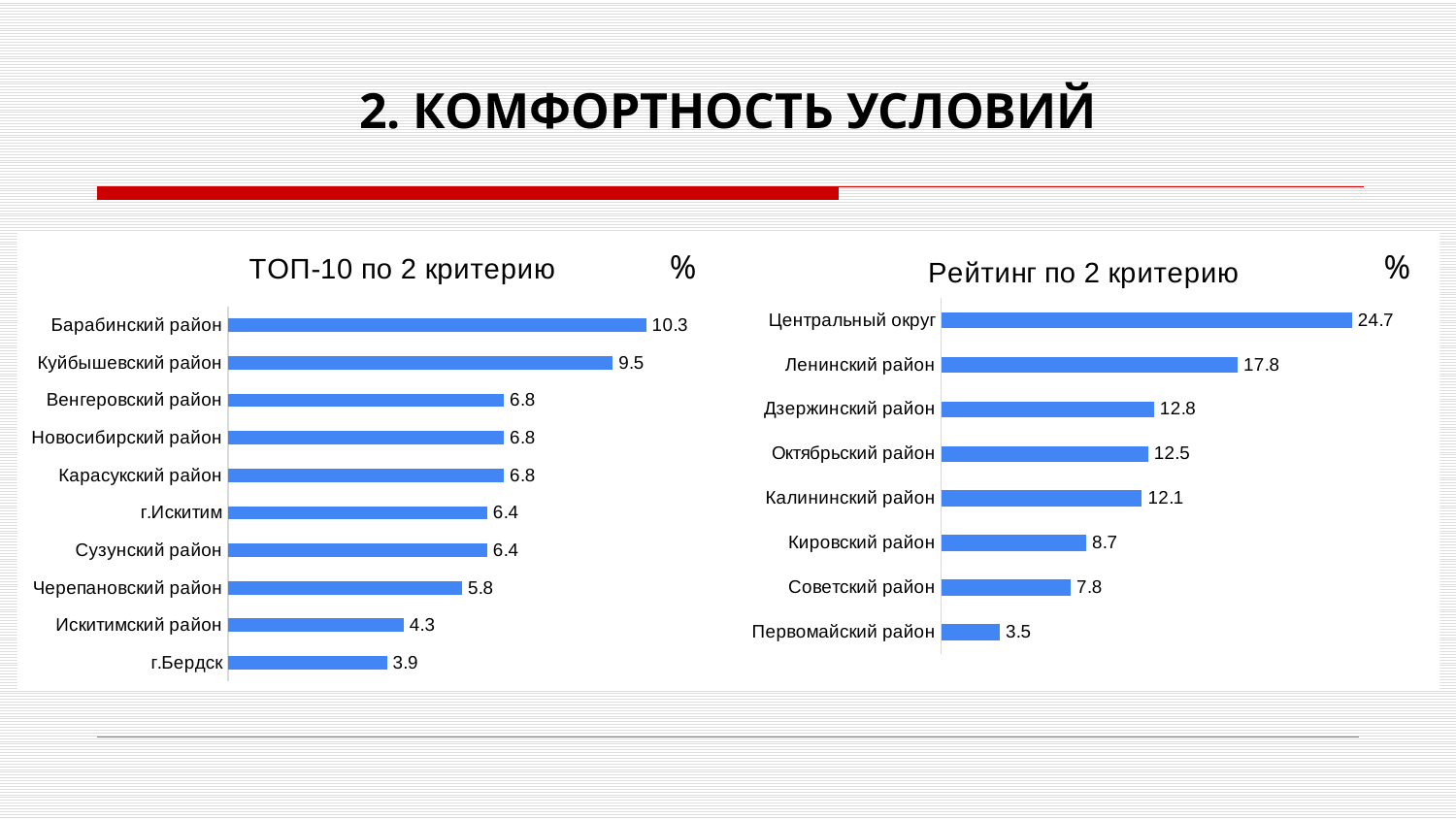
In the chart titled 'ТОП-10 по 2 критерию', which category has the lowest value? г.Бердск How many categories are shown in the chart titled 'Рейтинг по 2 критерию'? 8 In the chart titled 'Рейтинг по 2 критерию', which is larger: the value for Кировский район or Советский район? Кировский район In the chart titled 'ТОП-10 по 2 критерию', what is the value for Искитимский район? 4.3 How many categories are shown in the chart titled 'ТОП-10 по 2 критерию'? 10 In the chart titled 'Рейтинг по 2 критерию', which category has the lowest value? Первомайский район In the chart titled 'ТОП-10 по 2 критерию', what is the difference between the values for Барабинский район and Куйбышевский район? 0.8 In the chart titled 'ТОП-10 по 2 критерию', what is the value for Барабинский район? 10.3 In the chart titled 'Рейтинг по 2 критерию', which category has the highest value? Центральный округ What kind of chart is the chart titled 'Рейтинг по 2 критерию'? Bar chart In the chart titled 'Рейтинг по 2 критерию', what is the difference between the values for Центральный округ and Первомайский район? 21.2 In the chart titled 'Рейтинг по 2 критерию', what is the value for Ленинский район? 17.8